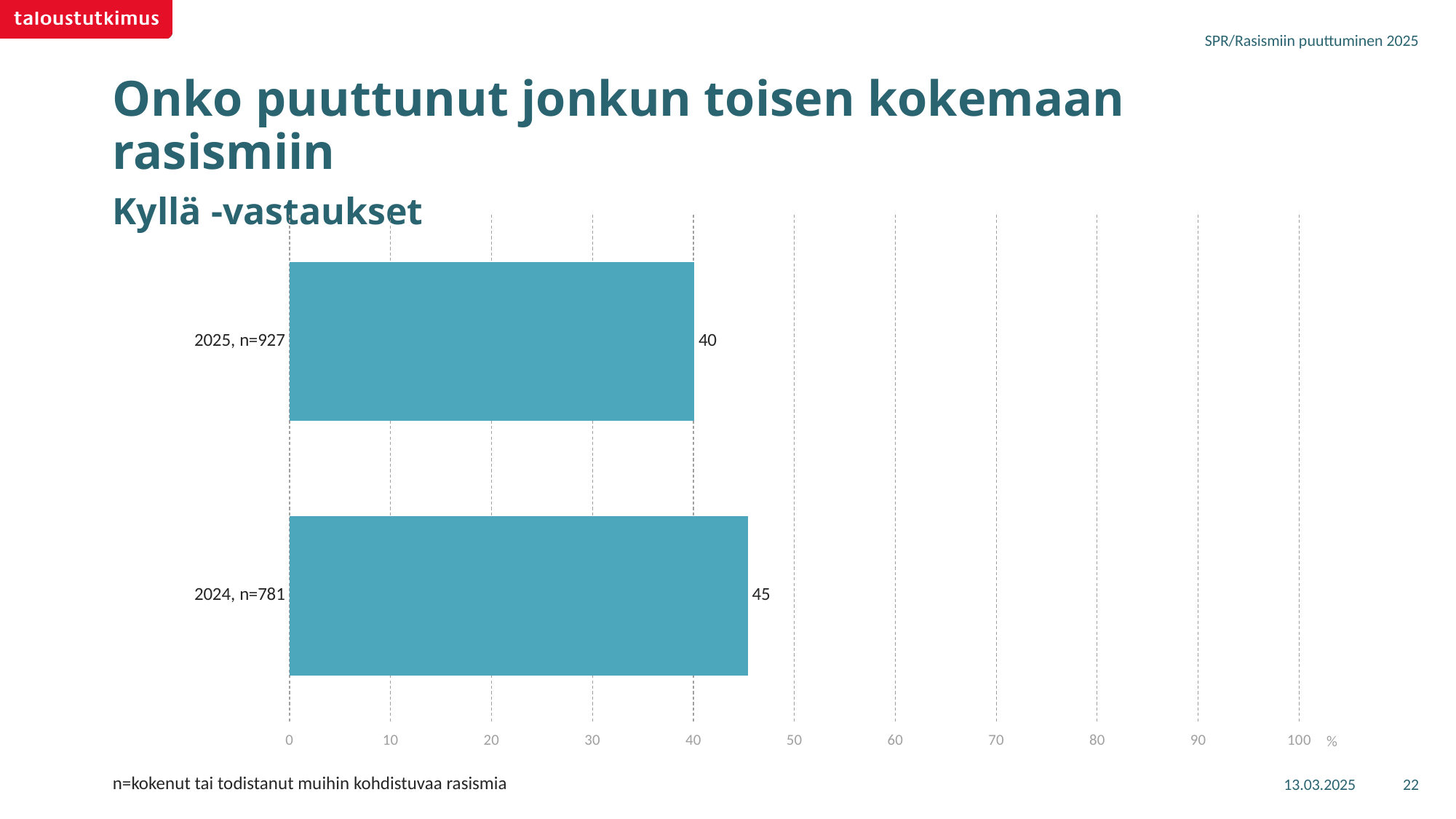
What is the value for 2024, n=781? 45 Which is larger, the value for 2025, n=927 or the value for 2024, n=781? 2024, n=781 What unit is shown at the end of the horizontal axis? % What is the maximum value shown on the horizontal axis? 100 Which category has the lowest value? 2025, n=927 What is the value for 2025, n=927? 40 How many categories are shown in the chart? 2 What is the difference between the values for 2024, n=781 and 2025, n=927? 5 Which category has the highest value? 2024, n=781 What is the subtitle shown above the chart? Kyllä -vastaukset What kind of chart is shown on the slide? bar chart Is the value for 2024, n=781 greater or less than 50? less